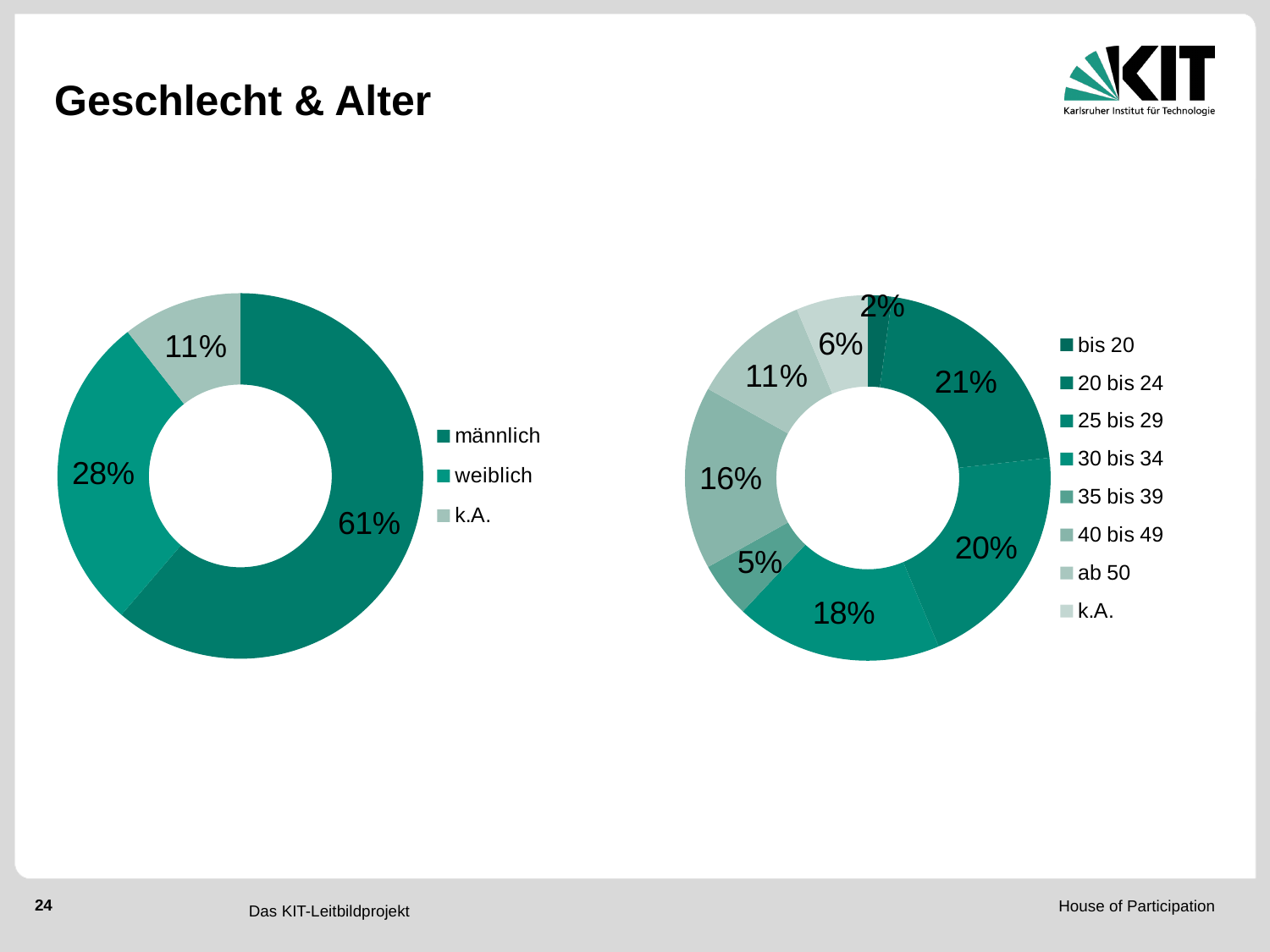
On the right chart, which age group has the smallest share? bis 20 How many entries does the legend of the left chart list? 3 What kind of chart is the left chart? doughnut chart On the left chart, what share is labelled for weiblich? 28% How many entries does the legend of the right chart list? 8 On the right chart, what share is labelled for 20 bis 24? 21% On the left chart, what is the difference between the männlich and weiblich shares? 33% On the left chart, which category has the smallest share? k.A. On the right chart, what share is labelled for 40 bis 49? 16% On the left chart, what share is labelled for männlich? 61% On the right chart, which is larger: the share for 30 bis 34 or the share for 35 bis 39? 30 bis 34 On the right chart, which age group has the largest share? 20 bis 24